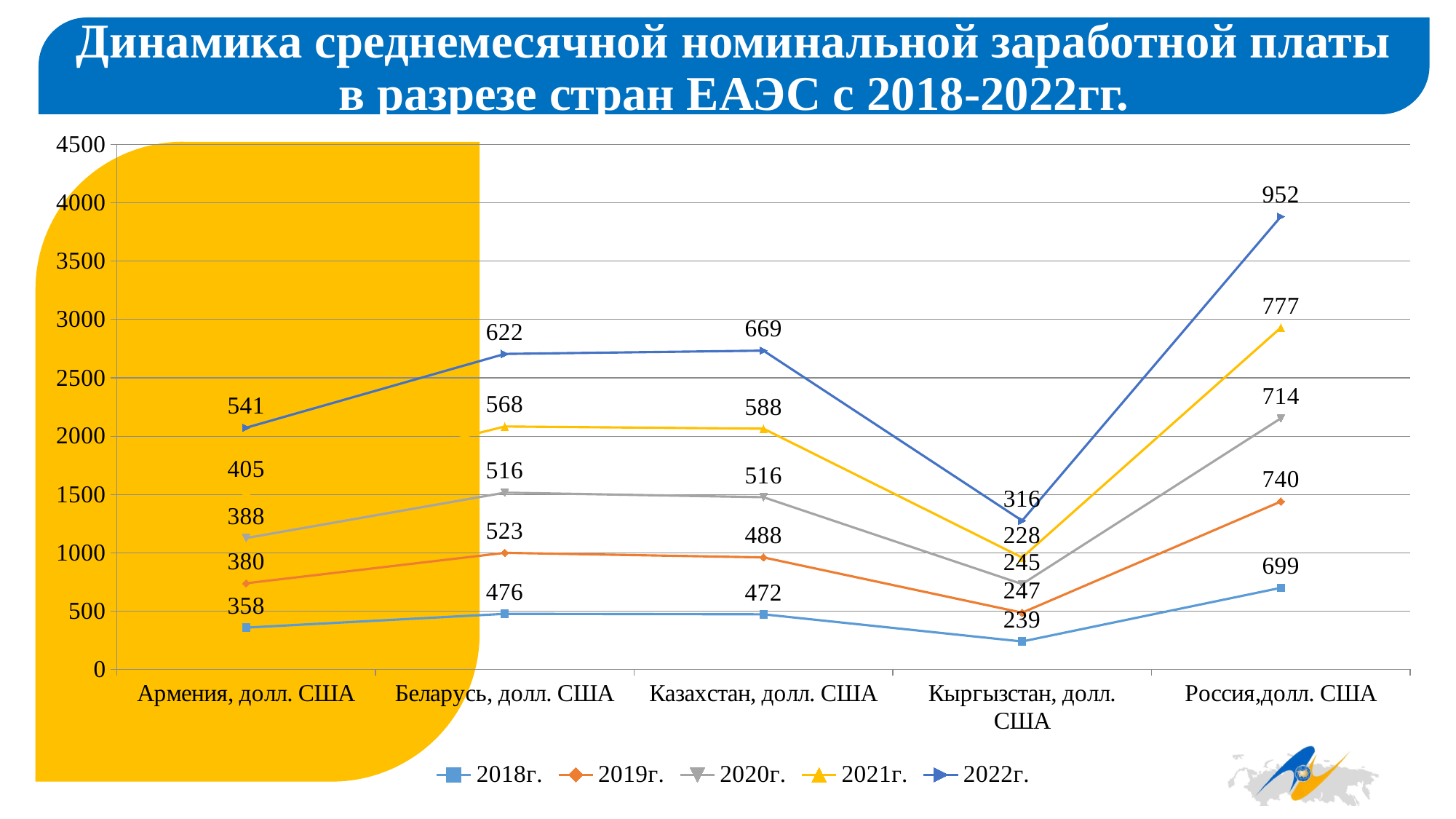
How many countries are shown on the x axis? 5 What type of chart is shown on the slide? line chart What is the value for Казахстан in the 2021г. series? 588 What is the value for Россия in the 2022г. series? 952 What is the value for Кыргызстан in the 2022г. series? 316 Which is larger in the 2019г. series: Беларусь or Казахстан? Беларусь Which country has the lowest value in the 2018г. series? Кыргызстан What is the value for Армения in the 2018г. series? 358 How many series does the legend list? 5 What is the difference between the 2022г. and 2018г. values for Россия? 253 Which country has the highest value in the 2022г. series? Россия Which series is drawn in yellow according to the legend? 2021г.